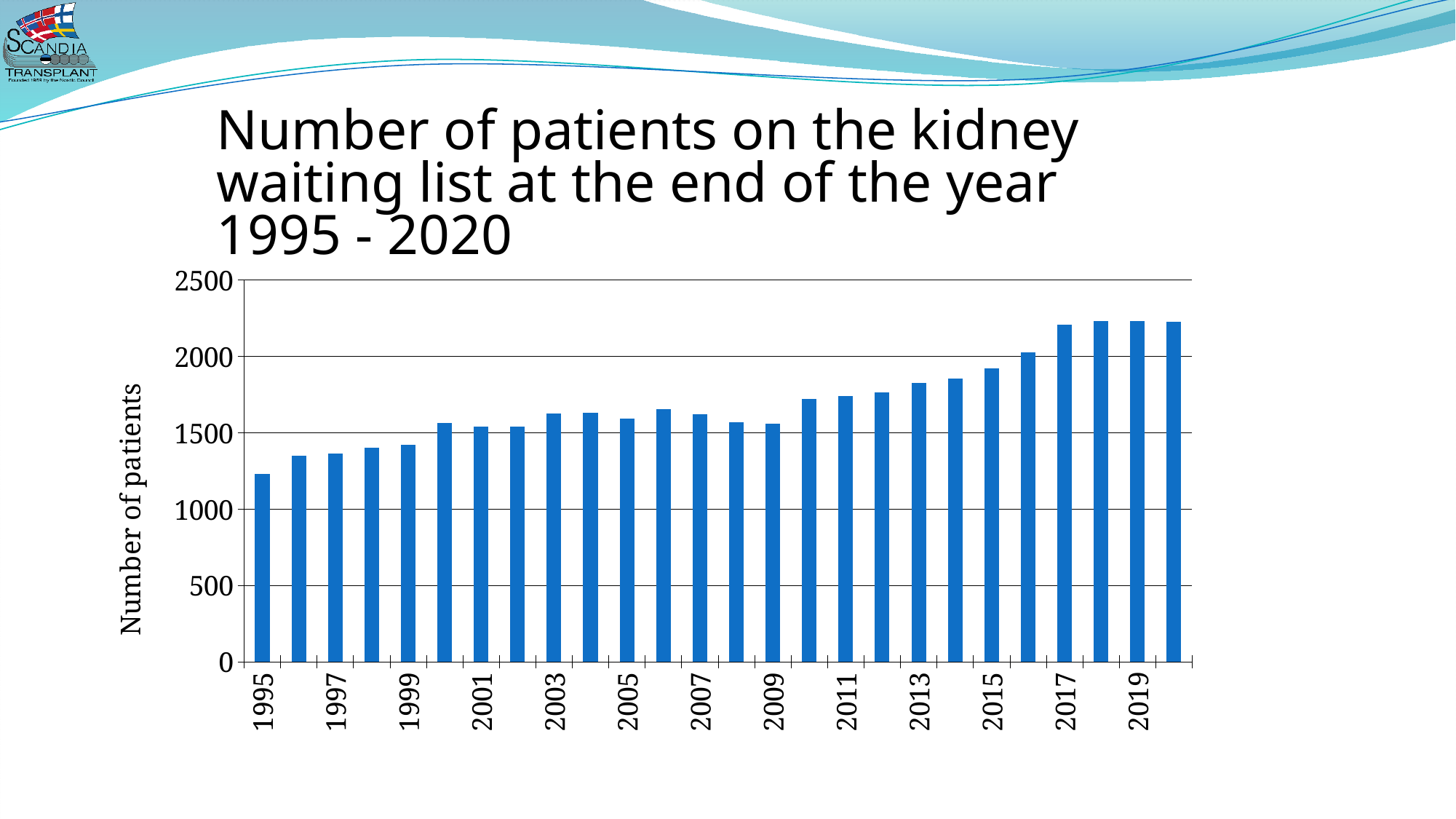
Is the value for 2010 greater or less than 1500? greater What kind of chart is shown on the slide? bar chart How many years (bars) are plotted in the chart? 26 Is the value for 2017 greater or less than 2000? greater Is the value for 1999 greater or less than 1500? less Which year has the lowest number of patients on the kidney waiting list? 1995 What is the label on the vertical axis of the chart? Number of patients Overall, does the number of patients on the kidney waiting list rise or fall from 1995 to 2020? rise Which year has more patients on the waiting list, 1995 or 1996? 1996 Which year has more patients on the waiting list, 2006 or 2009? 2006